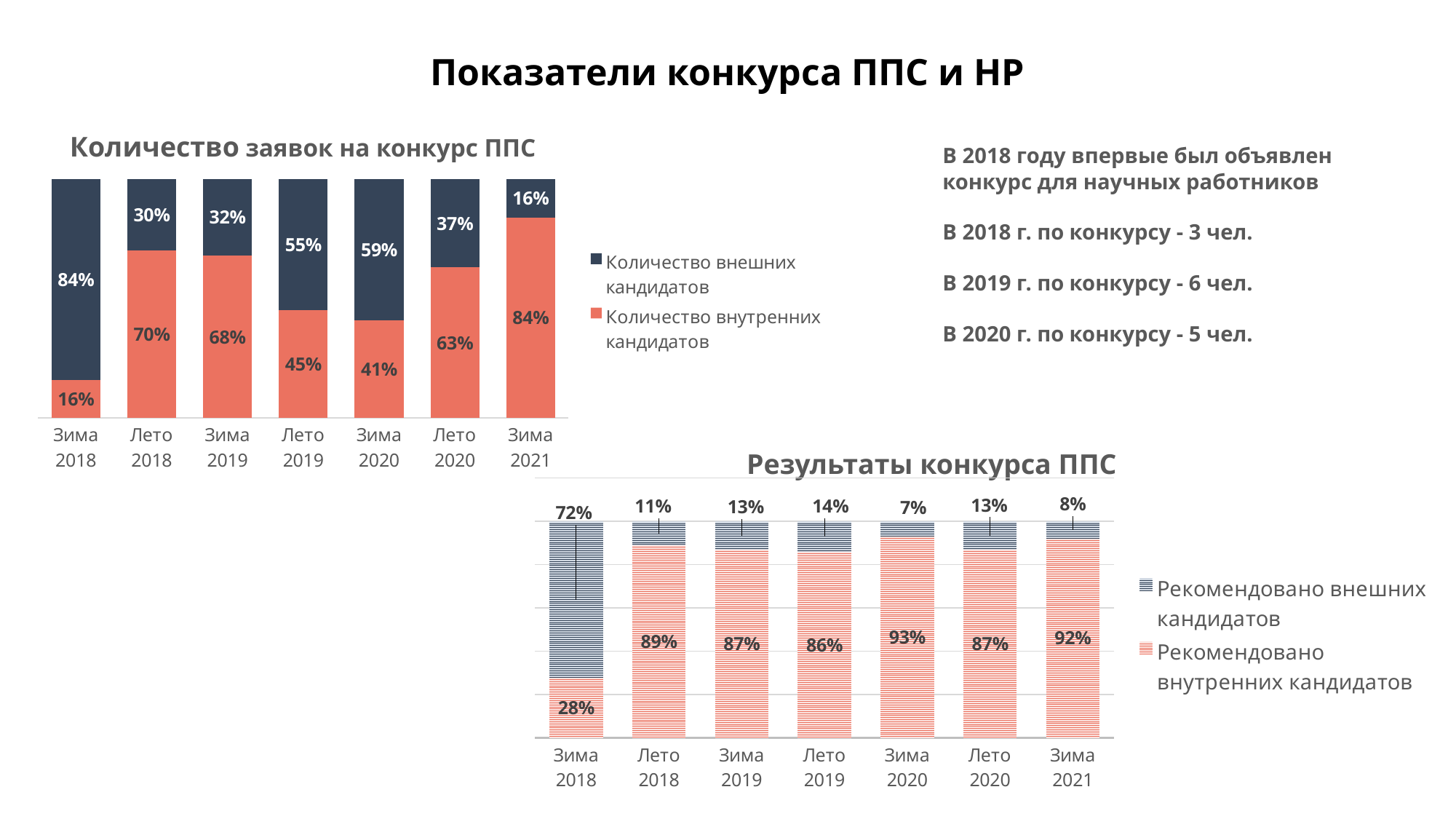
In the chart 'Результаты конкурса ППС', which period has the lowest share of recommended external candidates? Зима 2020 In the chart 'Количество заявок на конкурс ППС', what is the share of internal candidates (Количество внутренних кандидатов) for Лето 2019? 45% How many series does the legend of the chart 'Результаты конкурса ППС' list? 2 In the chart 'Количество заявок на конкурс ППС', which period has the lowest share of external candidates? Зима 2021 In the chart 'Количество заявок на конкурс ППС', what is the share of external candidates (Количество внешних кандидатов) for Зима 2018? 84% In the chart 'Количество заявок на конкурс ППС', what is the difference between the external candidate shares for Зима 2020 and Лето 2020? 22% In the chart 'Результаты конкурса ППС', is the share of recommended external candidates larger for Лето 2019 or Зима 2021? Лето 2019 In the chart 'Количество заявок на конкурс ППС', which period has the highest share of internal candidates? Зима 2021 In the chart 'Результаты конкурса ППС', what is the share of recommended external candidates for Зима 2018? 72% What type of chart is 'Количество заявок на конкурс ППС'? Stacked bar chart In the chart 'Количество заявок на конкурс ППС', how many periods are shown on the x axis? 7 In the chart 'Результаты конкурса ППС', what is the share of recommended internal candidates for Зима 2020? 93%